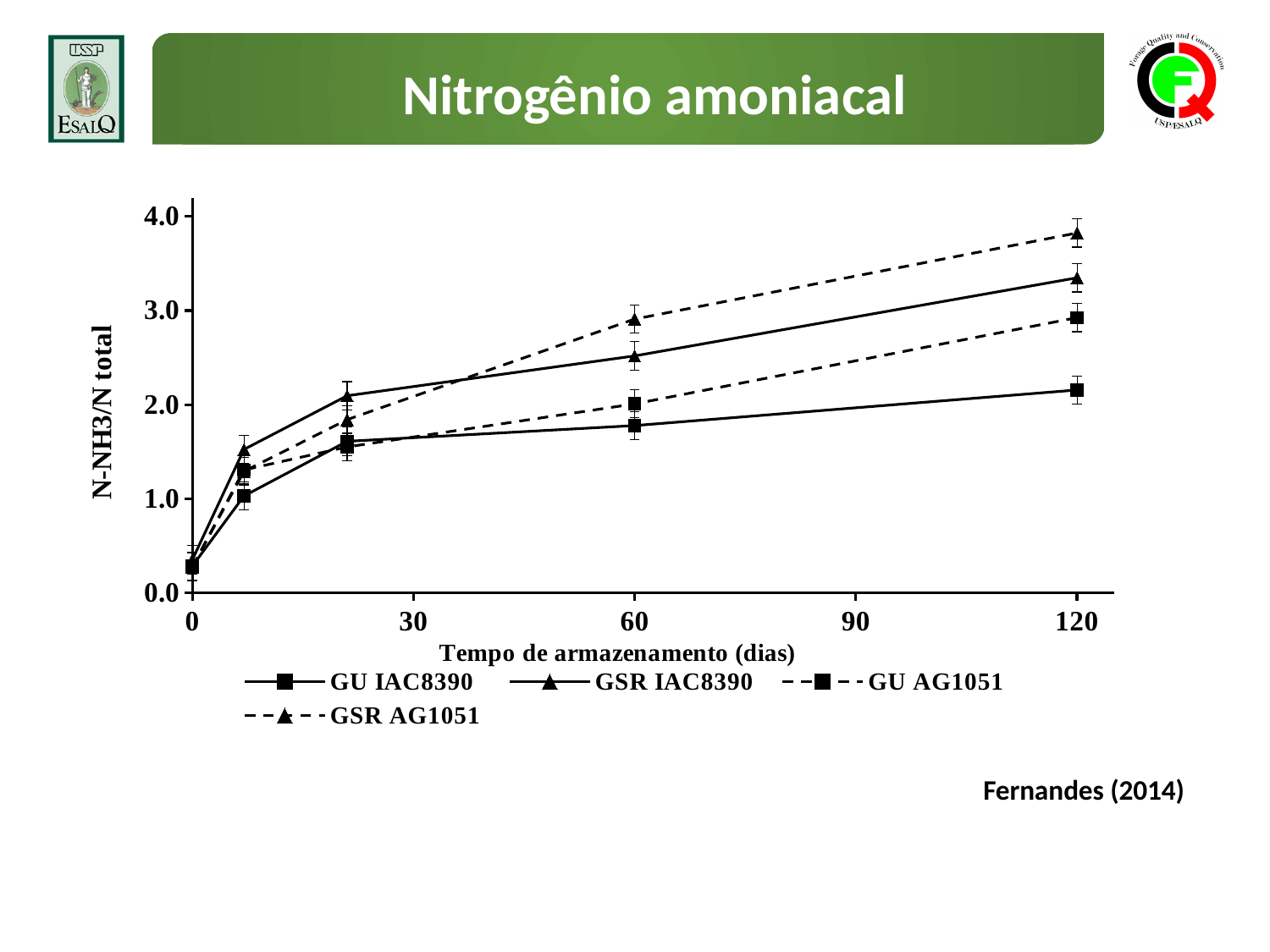
Is the value for GSR AG1051 at 60 days greater or less than 2.0? greater At 60 days, which is larger: GSR AG1051 or GU IAC8390? GSR AG1051 Is the value for GU IAC8390 at 120 days greater or less than 3.0? less Is the value for GSR IAC8390 at 0 days greater or less than 1.0? less Do the values for GSR IAC8390 rise or fall as storage time increases? rise Which series has the highest value at 120 days? GSR AG1051 What kind of chart is shown on the slide? line chart How many series does the legend list? 4 What is the label of the x axis? Tempo de armazenamento (dias) Which series has the lowest value at 120 days? GU IAC8390